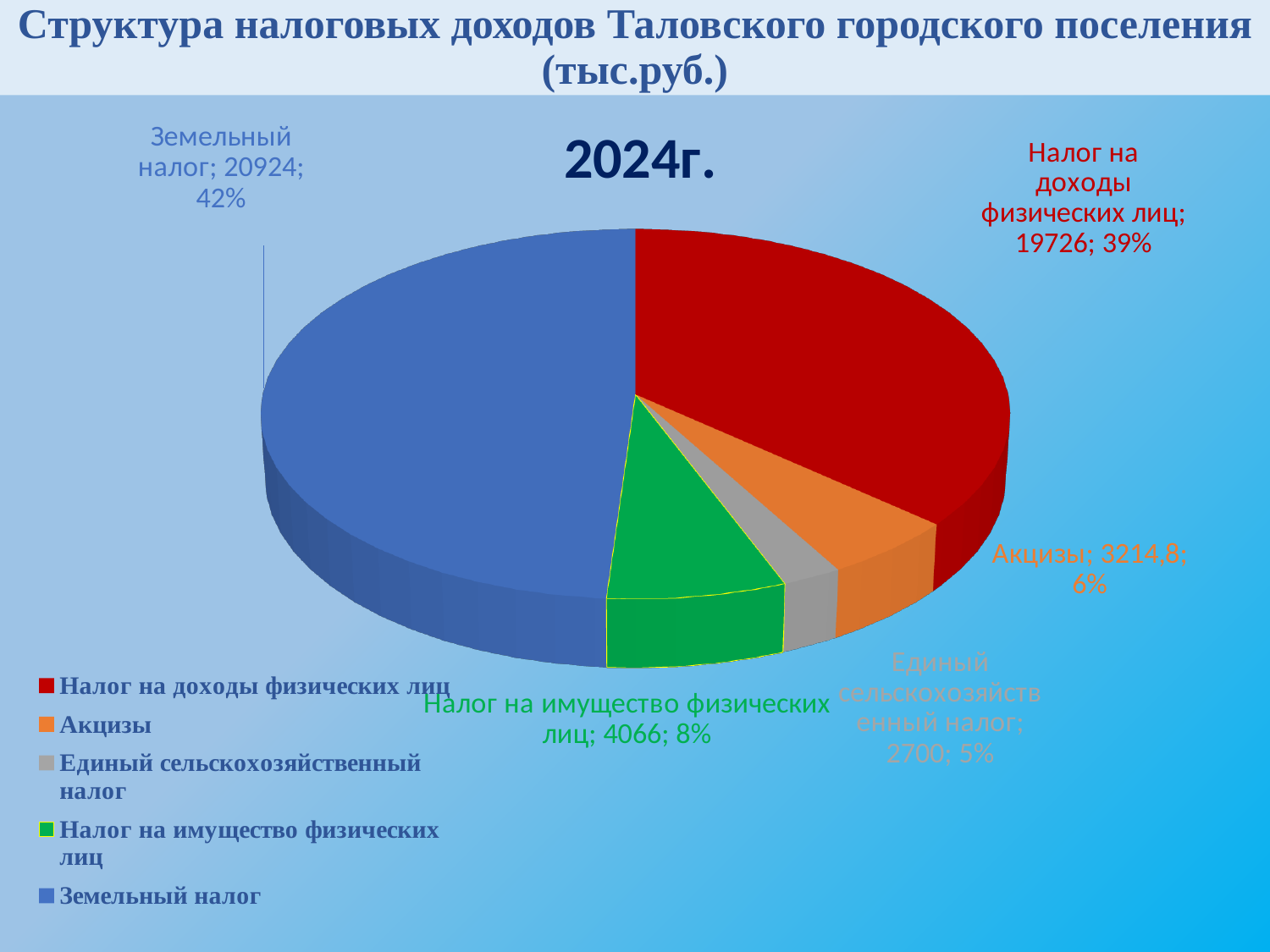
What is the value for Единый сельскохозяйственный налог? 2700 What type of chart is shown on the slide? Pie chart What share of the pie does Земельный налог represent? 42% How many categories does the pie chart show? 5 What share of the pie does Налог на имущество физических лиц represent? 8% Which category has the largest slice of the pie? Земельный налог Which category has the smallest slice of the pie? Единый сельскохозяйственный налог What is the value for Акцизы? 3214.8 Which is larger, Налог на имущество физических лиц or Акцизы? Налог на имущество физических лиц What is the value for Налог на доходы физических лиц? 19726 What is the difference between the values for Земельный налог and Налог на доходы физических лиц? 1198 What is the value for Земельный налог in the pie chart? 20924